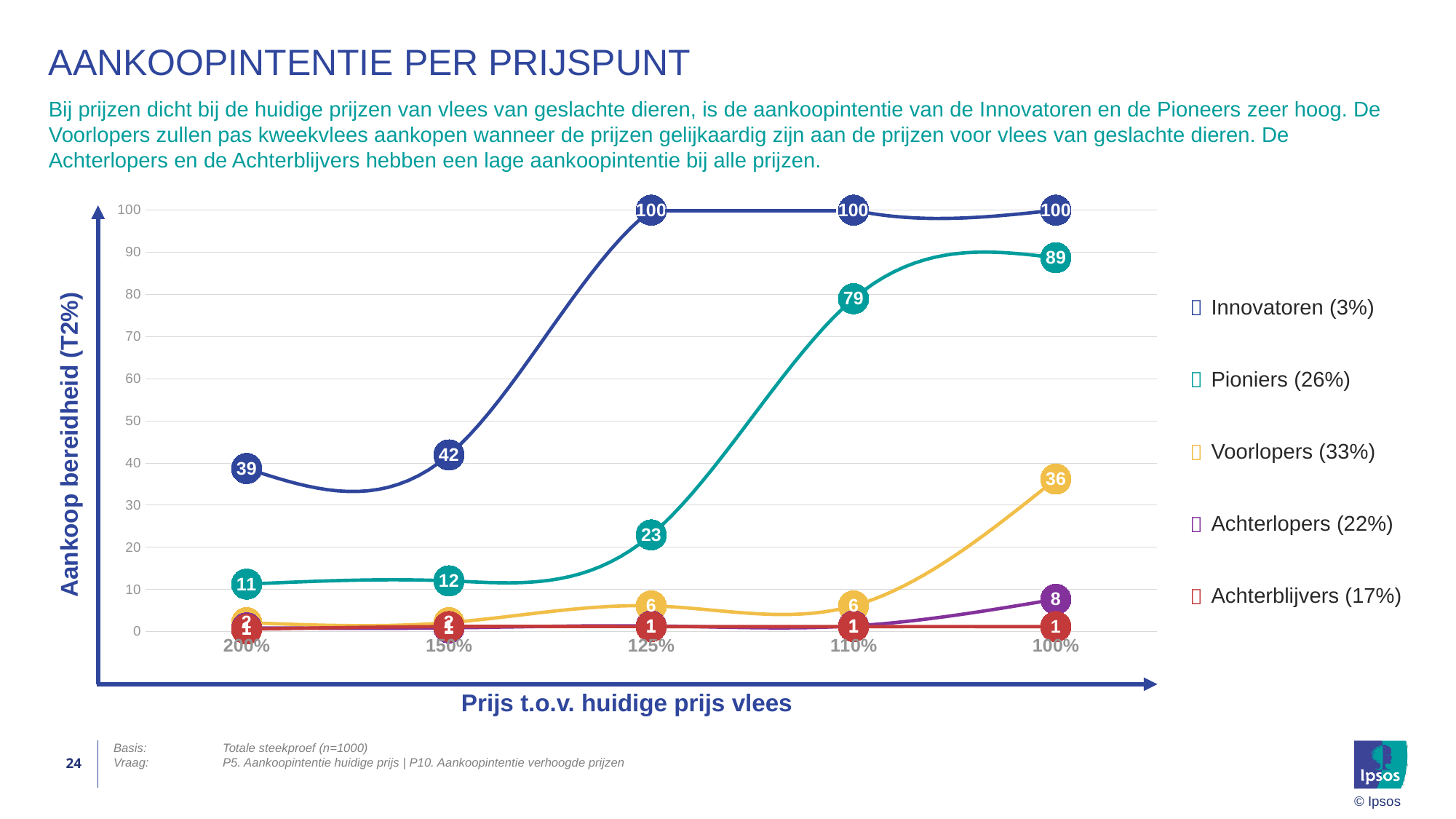
How many series does the legend list? 5 What is the value for Innovatoren at the 200% price point? 39 Which is larger at the 125% price point: Innovatoren or Pioniers? Innovatoren What is the value for Achterlopers at the 100% price point? 8 What kind of chart is shown on the slide? Line chart What is the difference between the Pioniers values at 100% and 110%? 10 How many price points are shown on the x axis? 5 What is the value for Voorlopers at the 100% price point? 36 Which series has the lowest value at the 100% price point? Achterblijvers (17%) What is the label of the y axis? Aankoop bereidheid (T2%) Which series has the highest value at the 100% price point? Innovatoren (3%) What is the value for Pioniers at the 110% price point? 79